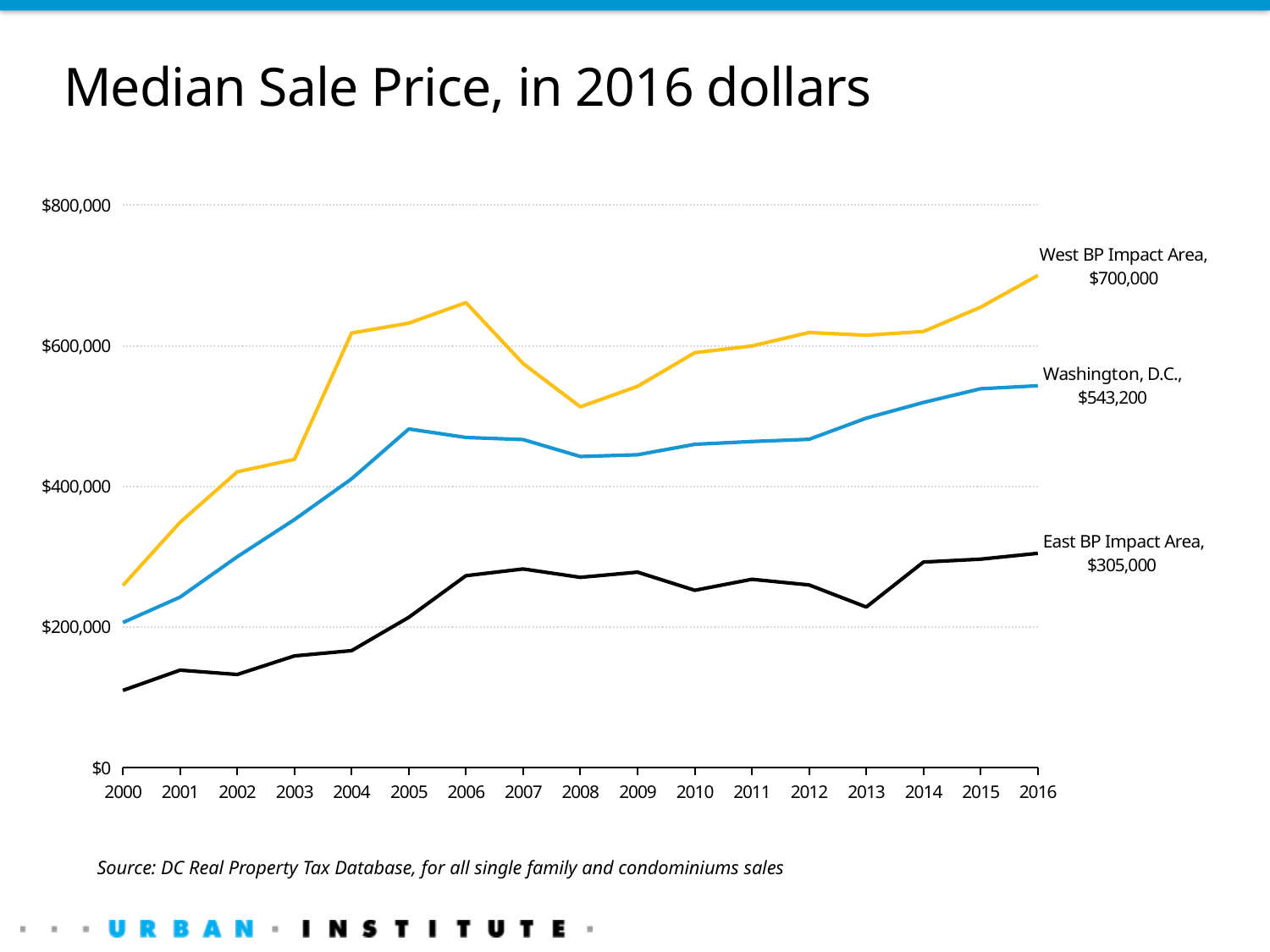
Is the median sale price for the West BP Impact Area in 2005 greater or less than $600,000? greater Which series has the highest median sale price in 2016? West BP Impact Area What is the median sale price for the West BP Impact Area in 2016? $700,000 In 2016, is the median sale price higher in Washington, D.C. or in the East BP Impact Area? Washington, D.C. Which series has the lowest median sale price in 2016? East BP Impact Area What is the difference between the 2016 median sale price in the West BP Impact Area and in Washington, D.C.? $156,800 What is the median sale price for the East BP Impact Area in 2016? $305,000 What is the difference between the 2016 median sale price in the West BP Impact Area and in the East BP Impact Area? $395,000 Is the median sale price for the East BP Impact Area in 2000 greater or less than $200,000? less What is the median sale price for Washington, D.C. in 2016? $543,200 How many series are plotted on the chart? 3 What kind of chart is shown on the slide? Line chart